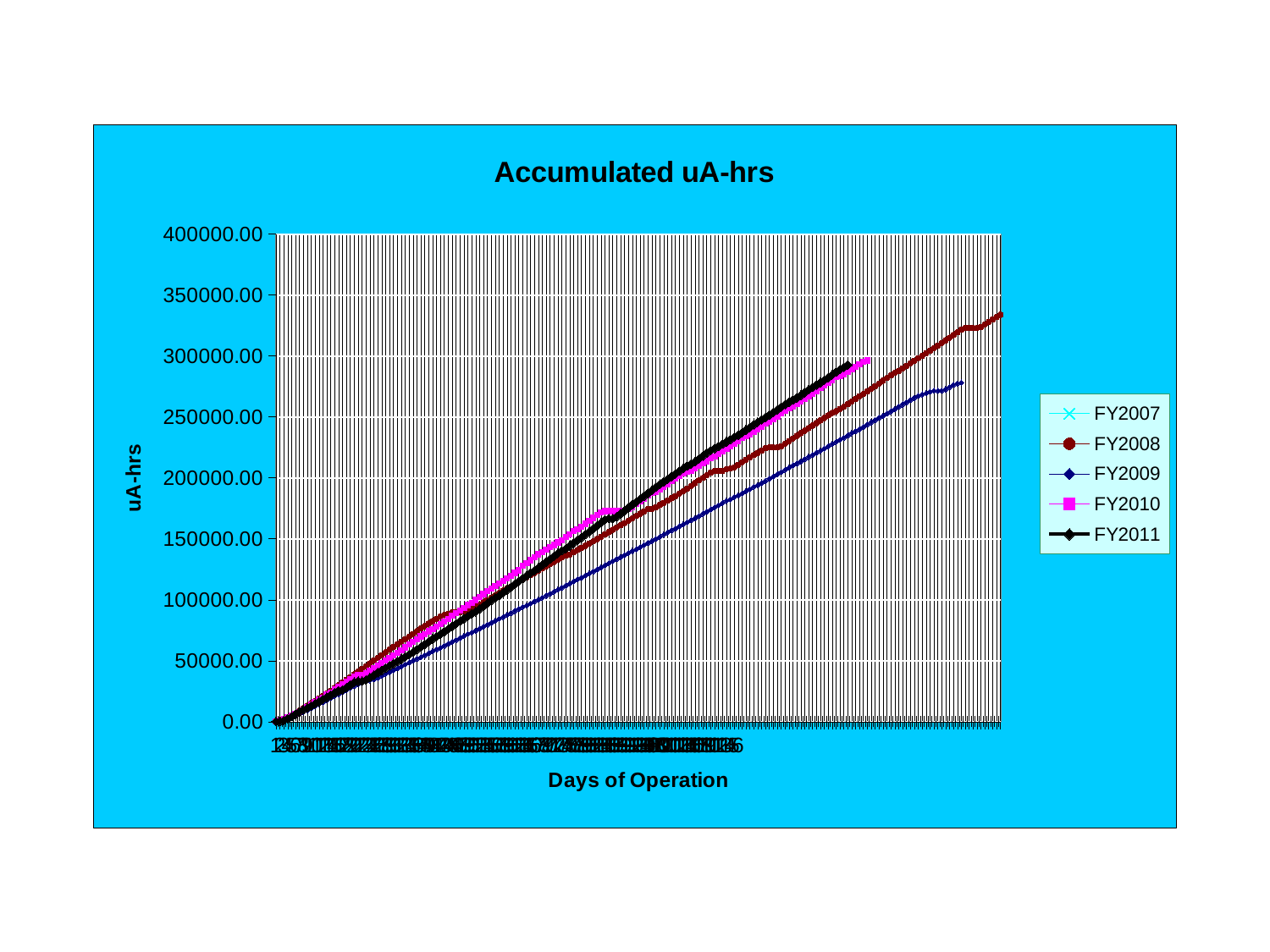
How many series does the legend list? 5 What is the label of the x axis? Days of Operation Which series ends at a higher value, FY2008 or FY2009? FY2008 Which series reaches the highest accumulated uA-hrs value on the chart? FY2008 Is the final value of the FY2008 series greater or less than 350000.00? less What kind of chart is shown on the slide? line chart What is the title of the chart? Accumulated uA-hrs Is the final value of the FY2009 series greater or less than 300000.00? less Is the final value of the FY2008 series greater or less than 300000.00? greater Do the plotted values rise or fall as the days of operation increase? rise